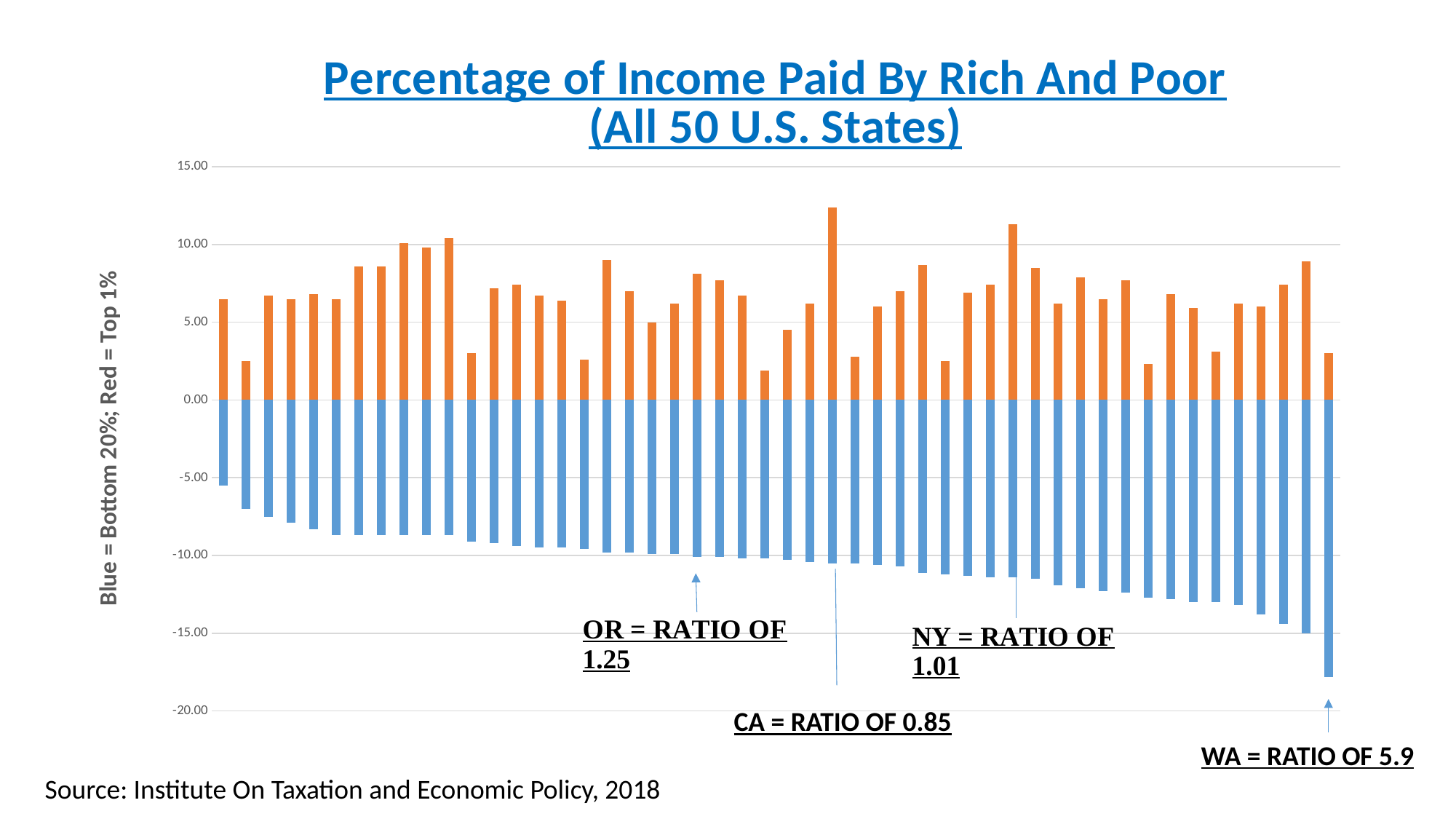
What kind of chart is shown on the slide? Bar chart What is the title of the chart? Percentage of Income Paid By Rich And Poor (All 50 U.S. States) What ratio is given for NY in the chart annotation? 1.01 Is the orange (Top 1%) value for WA greater or less than 5.00? less Do the blue (Bottom 20%) bars generally rise or fall moving from left to right along the x axis? fall Is the blue (Bottom 20%) value for WA greater or less than -15.00? less How many states are plotted in the chart, according to its title? 50 What ratio is given for WA in the chart annotation? 5.9 According to the axis label, which group do the blue bars represent? Bottom 20% Which annotated state has the lowest blue (Bottom 20%) bar? WA What ratio is given for CA in the chart annotation? 0.85 What ratio is given for OR in the chart annotation? 1.25